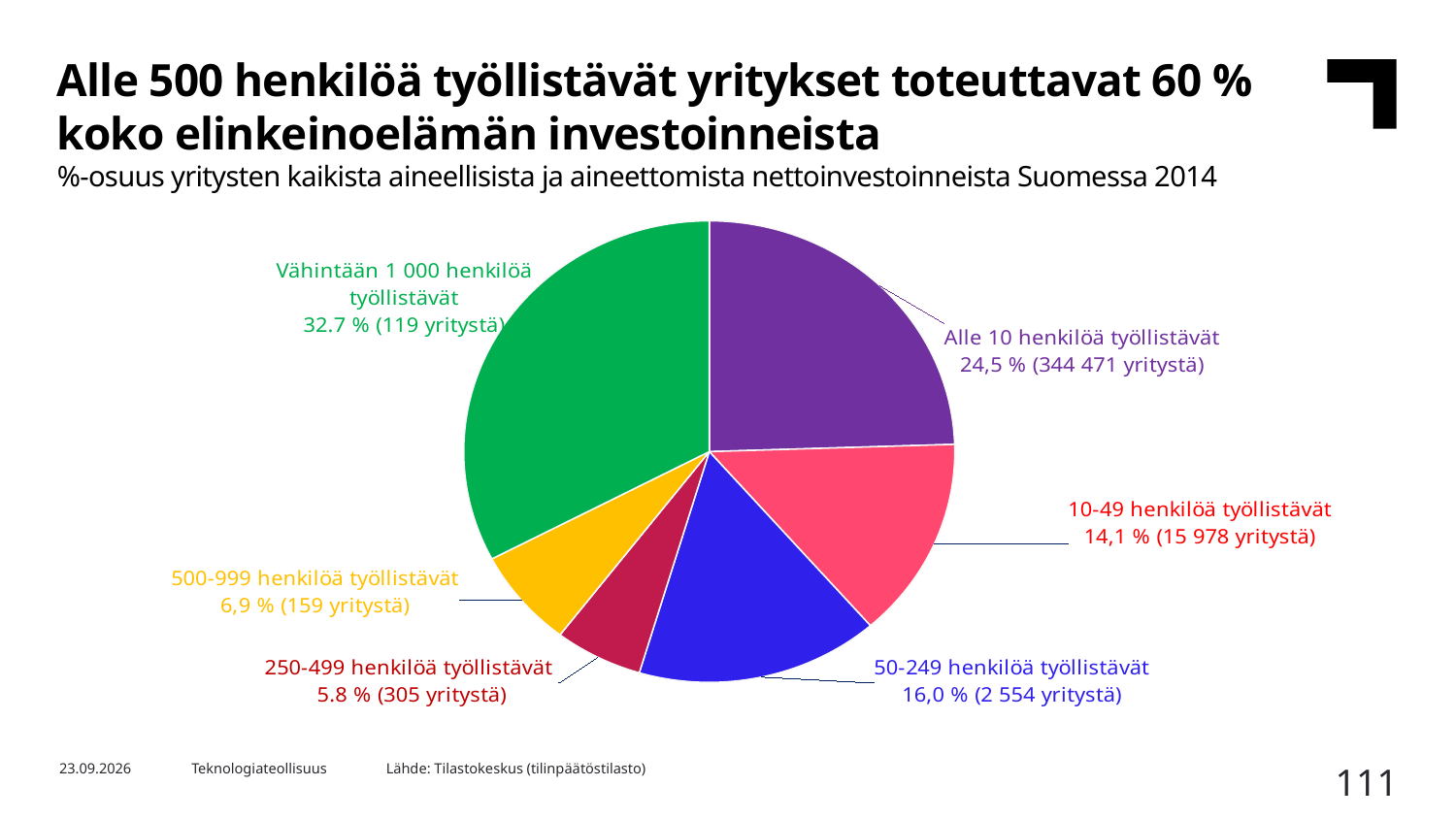
What is the difference in percentage points between the 50-249 henkilöä työllistävät share and the 10-49 henkilöä työllistävät share? 1,9 percentage points What type of chart is shown on the slide? Pie chart How many companies are in the 50-249 henkilöä työllistävät group? 2 554 yritystä What share of investments is attributed to companies employing at least 1 000 people (Vähintään 1 000 henkilöä työllistävät)? 32.7 % What colour is the slice for 500-999 henkilöä työllistävät? Yellow How many slices does the pie chart have? 6 How many companies are in the Alle 10 henkilöä työllistävät group? 344 471 yritystä What share of investments is attributed to companies employing fewer than 10 people (Alle 10 henkilöä työllistävät)? 24,5 % Which company size group has the smallest share of investments? 250-499 henkilöä työllistävät Which has a larger share of investments: 500-999 henkilöä työllistävät or 250-499 henkilöä työllistävät? 500-999 henkilöä työllistävät What year does the chart's data refer to, according to the subtitle? 2014 Which company size group has the largest share of investments? Vähintään 1 000 henkilöä työllistävät